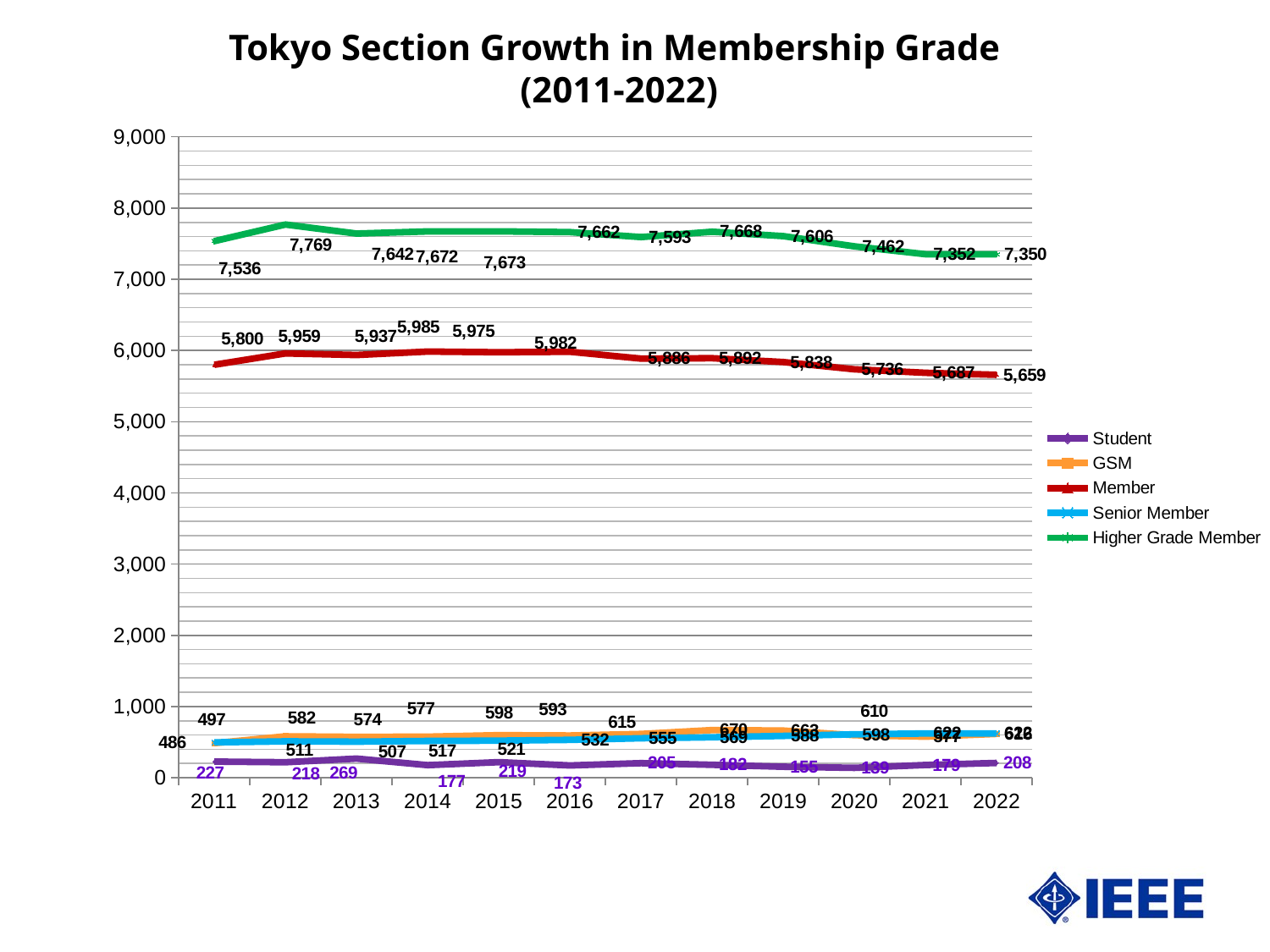
In which year is the Higher Grade Member value highest? 2012 In which year is the Student value lowest? 2020 Which is larger, the Member value for 2014 or the Member value for 2020? 2014 Do the Member values rise or fall from 2016 to 2022? Fall What is the Member value for 2022? 5,659 How many years are plotted along the x axis? 12 What is the GSM value for 2011? 486 How many series does the legend list? 5 What is the Student value for 2013? 269 What is the difference between the Higher Grade Member values for 2011 and 2022? 186 What is the Higher Grade Member value for 2012? 7,769 What type of chart is shown on the slide? Line chart